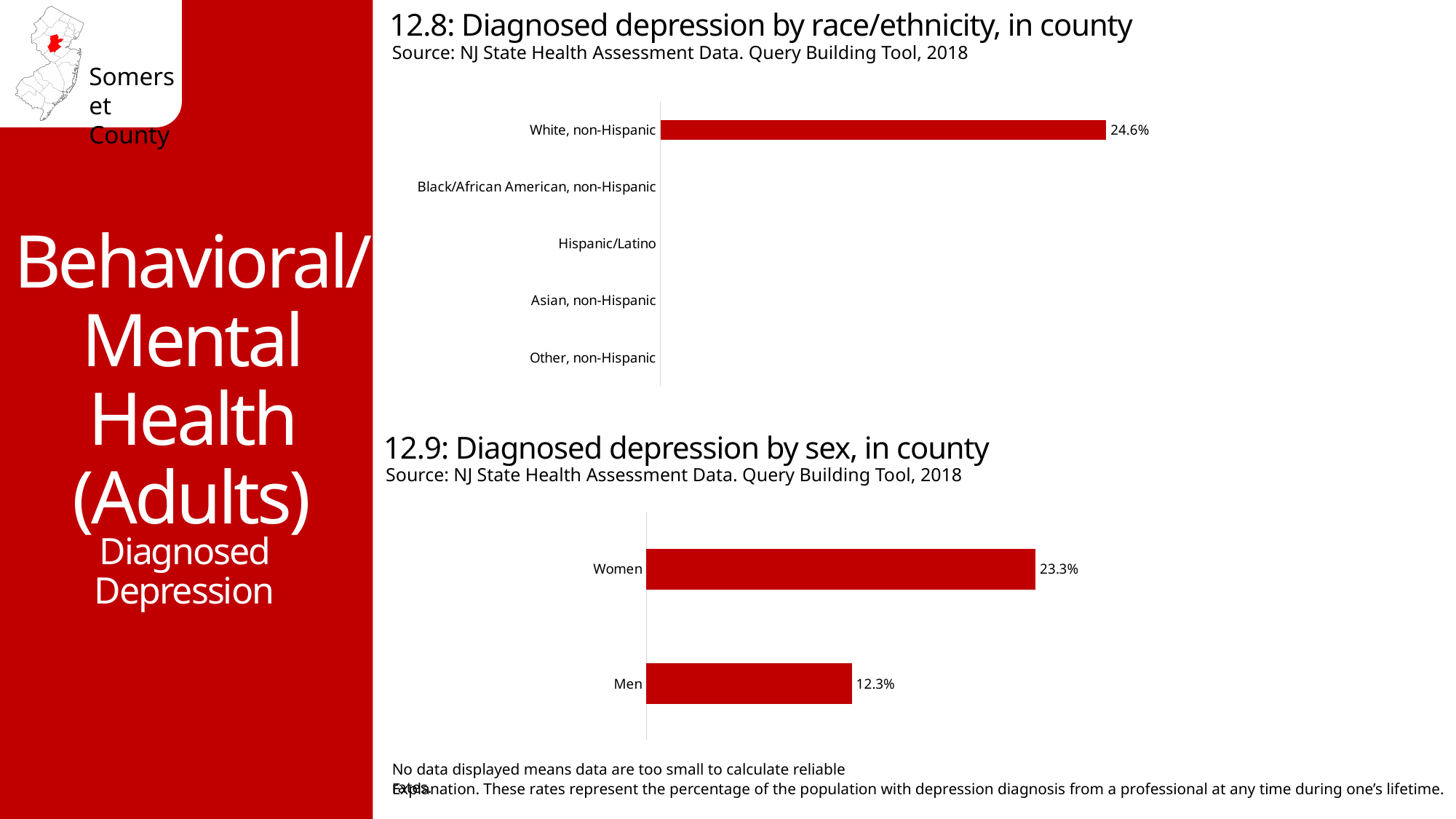
In chart 12.9 (Diagnosed depression by sex), which category has the lowest value? Men In chart 12.9 (Diagnosed depression by sex), is the value for Women or Men larger? Women In chart 12.9 (Diagnosed depression by sex), what is the value for Men? 12.3% In chart 12.8 (Diagnosed depression by race/ethnicity), how many race/ethnicity categories are listed on the axis? 5 In chart 12.9 (Diagnosed depression by sex), which category has the highest value? Women In chart 12.9 (Diagnosed depression by sex), what is the value for Women? 23.3% In chart 12.8 (Diagnosed depression by race/ethnicity), which category is the only one with a bar displayed? White, non-Hispanic In chart 12.9 (Diagnosed depression by sex), how many categories are shown? 2 What kind of chart is chart 12.8 (Diagnosed depression by race/ethnicity)? Bar chart In chart 12.8 (Diagnosed depression by race/ethnicity), what is the value for White, non-Hispanic? 24.6% In chart 12.9 (Diagnosed depression by sex), what is the difference between the values for Women and Men? 11.0% What kind of chart is chart 12.9 (Diagnosed depression by sex)? Bar chart